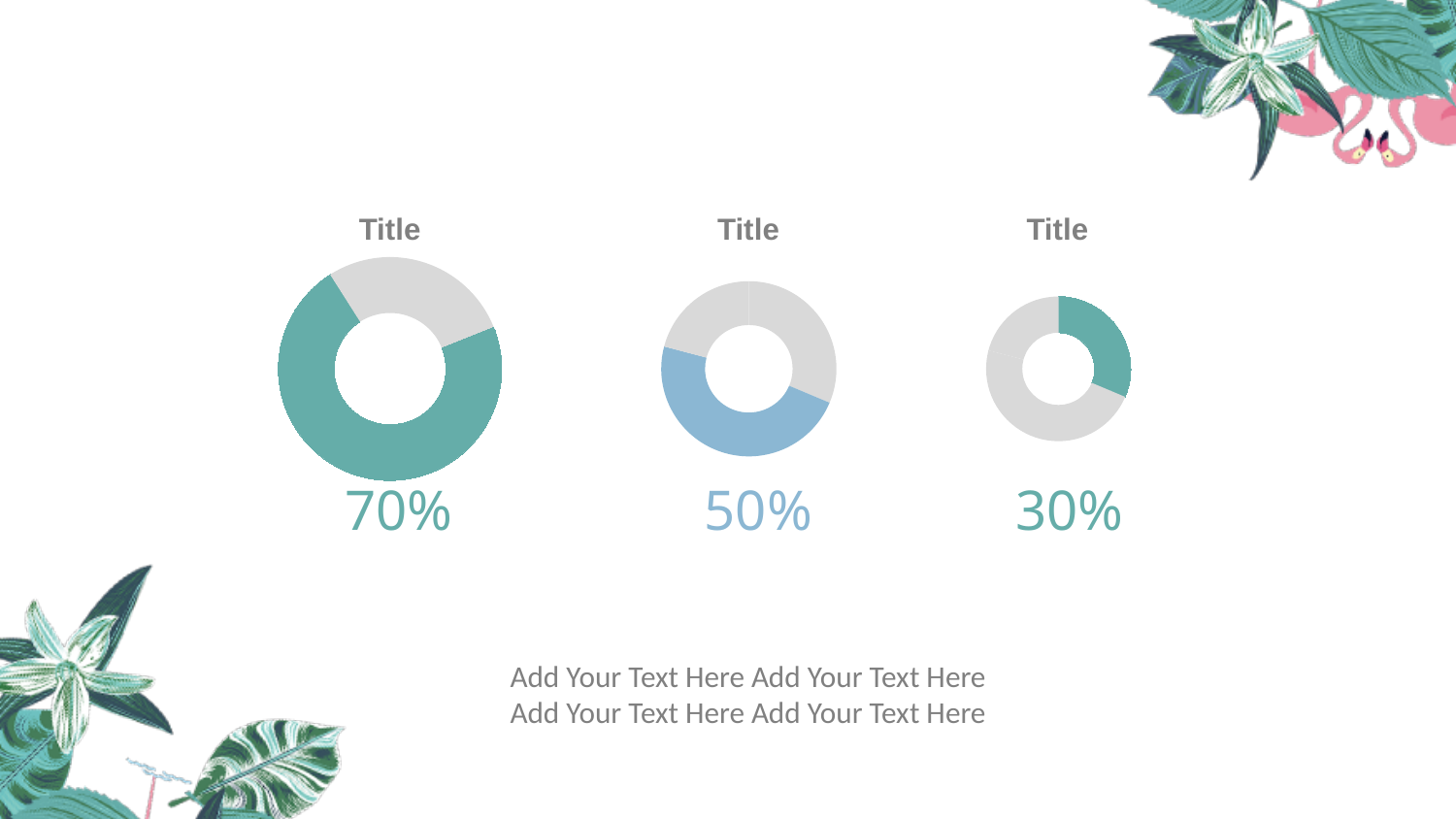
What percentage is shown below the right donut chart? 30% Which of the three donut charts shows the highest percentage: left, middle or right? left What is the difference between the percentage on the left chart and the percentage on the right chart? 40% What title is shown above each donut chart? Title What is the difference between the percentage on the middle chart and the percentage on the right chart? 20% What percentage is shown below the left donut chart? 70% What colour is the filled portion of the middle donut chart? blue What percentage is shown below the middle donut chart? 50% How many donut charts are on the slide? 3 Which of the three donut charts shows the lowest percentage: left, middle or right? right What kind of chart is used on this slide? donut chart Is the percentage on the left chart larger or smaller than the percentage on the right chart? larger